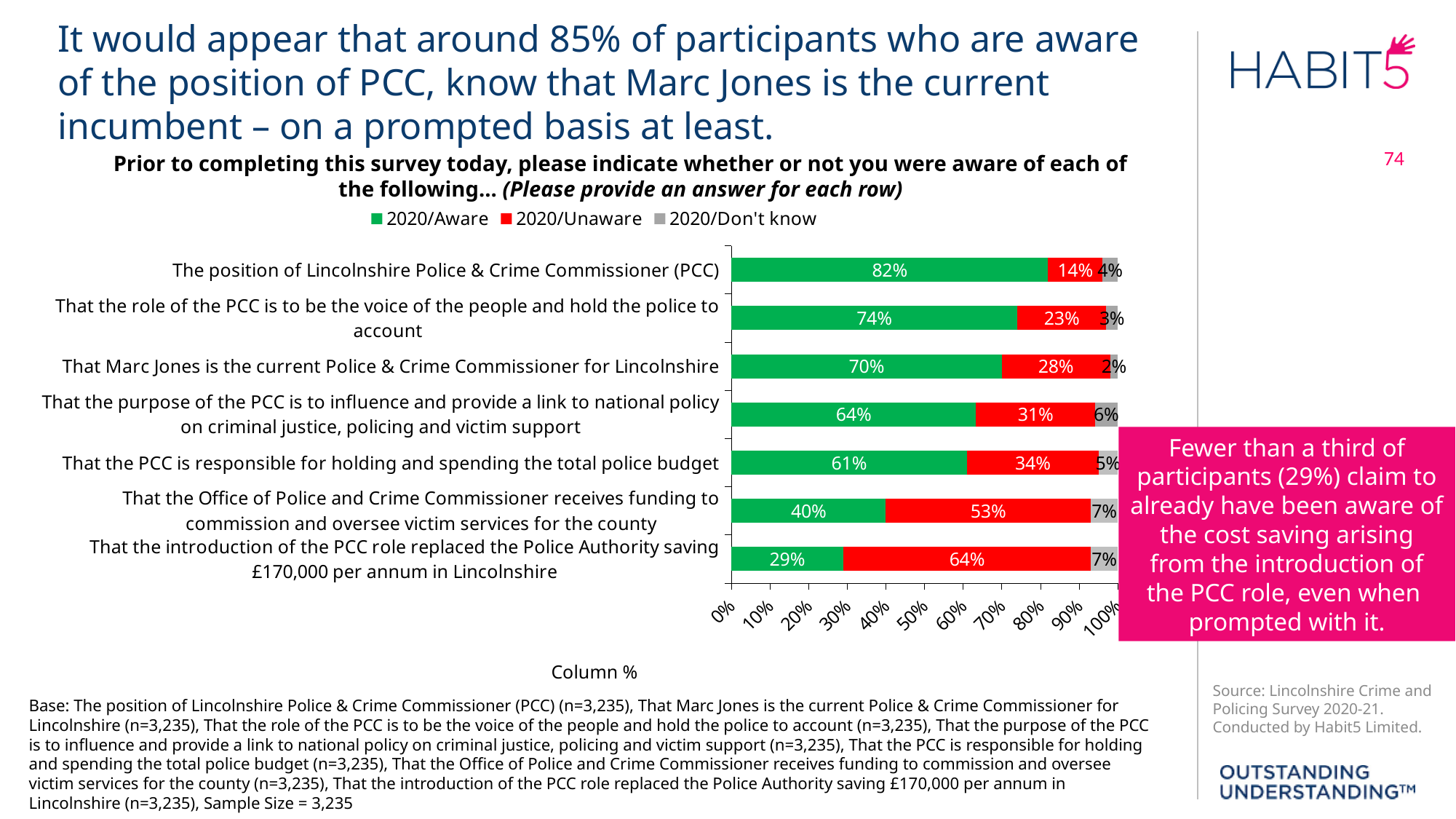
How many statements (categories) are shown in the chart? 7 What is the 2020/Don't know value for the statement that the Office of Police and Crime Commissioner receives funding to commission and oversee victim services for the county? 7% What percentage of participants were aware of the position of Lincolnshire Police & Crime Commissioner (PCC)? 82% What is the difference between the 2020/Aware percentages for the position of Lincolnshire PCC and for the PCC being responsible for holding and spending the total police budget? 21% What type of chart is shown on the slide? Stacked bar chart Which colour represents the 2020/Unaware series in the chart? Red What percentage of participants were unaware that Marc Jones is the current Police & Crime Commissioner for Lincolnshire? 28% Which statement has the lowest 2020/Aware percentage? That the introduction of the PCC role replaced the Police Authority saving £170,000 per annum in Lincolnshire Which statement has the highest 2020/Unaware percentage? That the introduction of the PCC role replaced the Police Authority saving £170,000 per annum in Lincolnshire Which is larger: the 2020/Aware value for the role of the PCC being the voice of the people, or the 2020/Aware value for the purpose of the PCC being to influence national policy? The role of the PCC being the voice of the people (74%) How many series does the legend list? 3 What is the total of the stacked bar for the statement that the PCC is responsible for holding and spending the total police budget? 100%